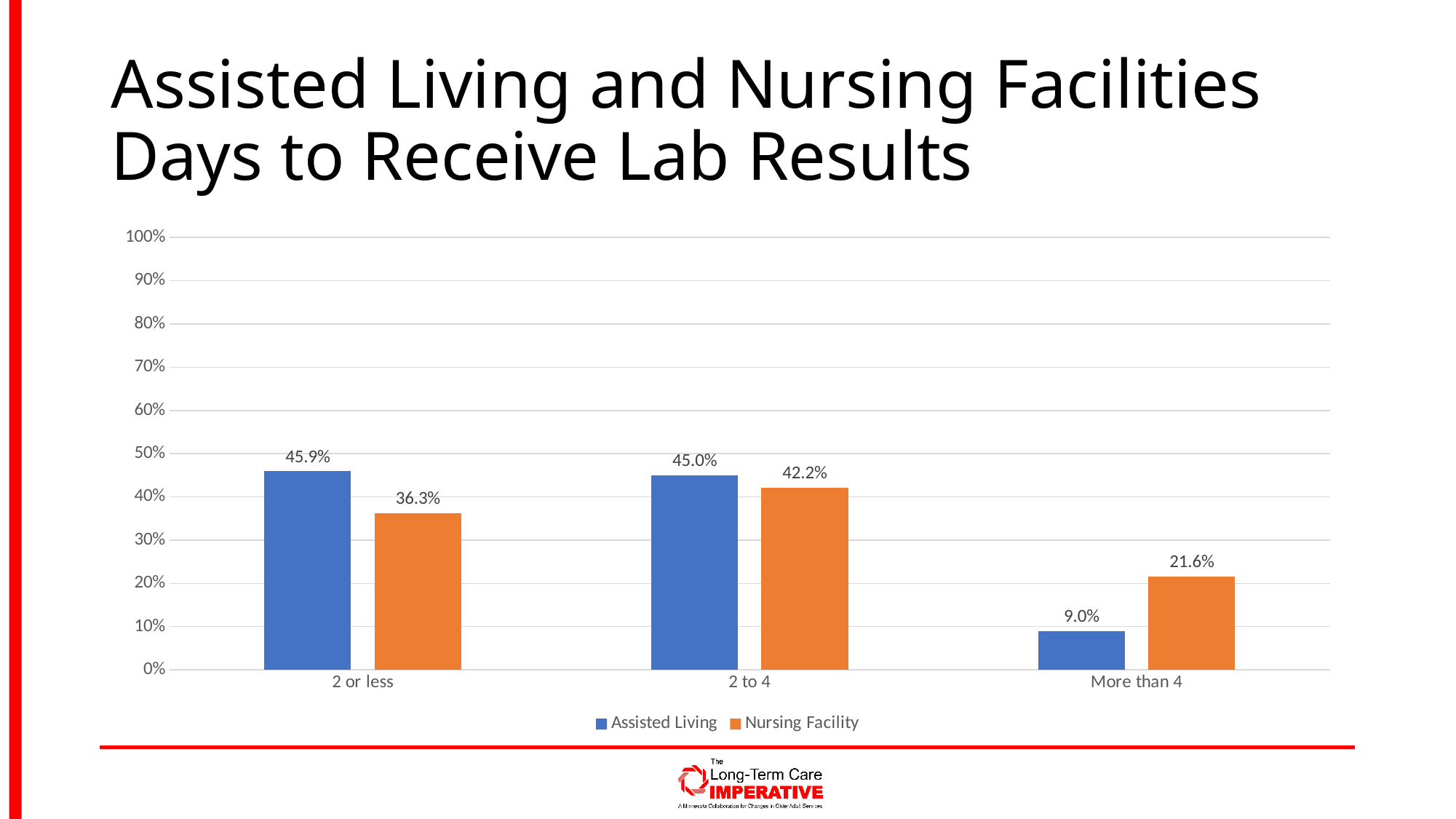
Is the Assisted Living value for '2 to 4' greater or less than 40%? greater How many categories are shown on the x axis? 3 What is the difference between the Nursing Facility and Assisted Living values for 'More than 4'? 12.6% Which category has the highest Nursing Facility value? 2 to 4 What kind of chart is shown on the slide? Bar chart Which category has the lowest Assisted Living value? More than 4 For the 'More than 4' category, which series has the larger value, Assisted Living or Nursing Facility? Nursing Facility What is the difference between the Assisted Living and Nursing Facility values for '2 or less'? 9.6% What is the Nursing Facility value for the '2 to 4' category? 42.2% What is the Assisted Living value for the '2 or less' category? 45.9% What is the Nursing Facility value for the 'More than 4' category? 21.6% How many series does the legend list? 2